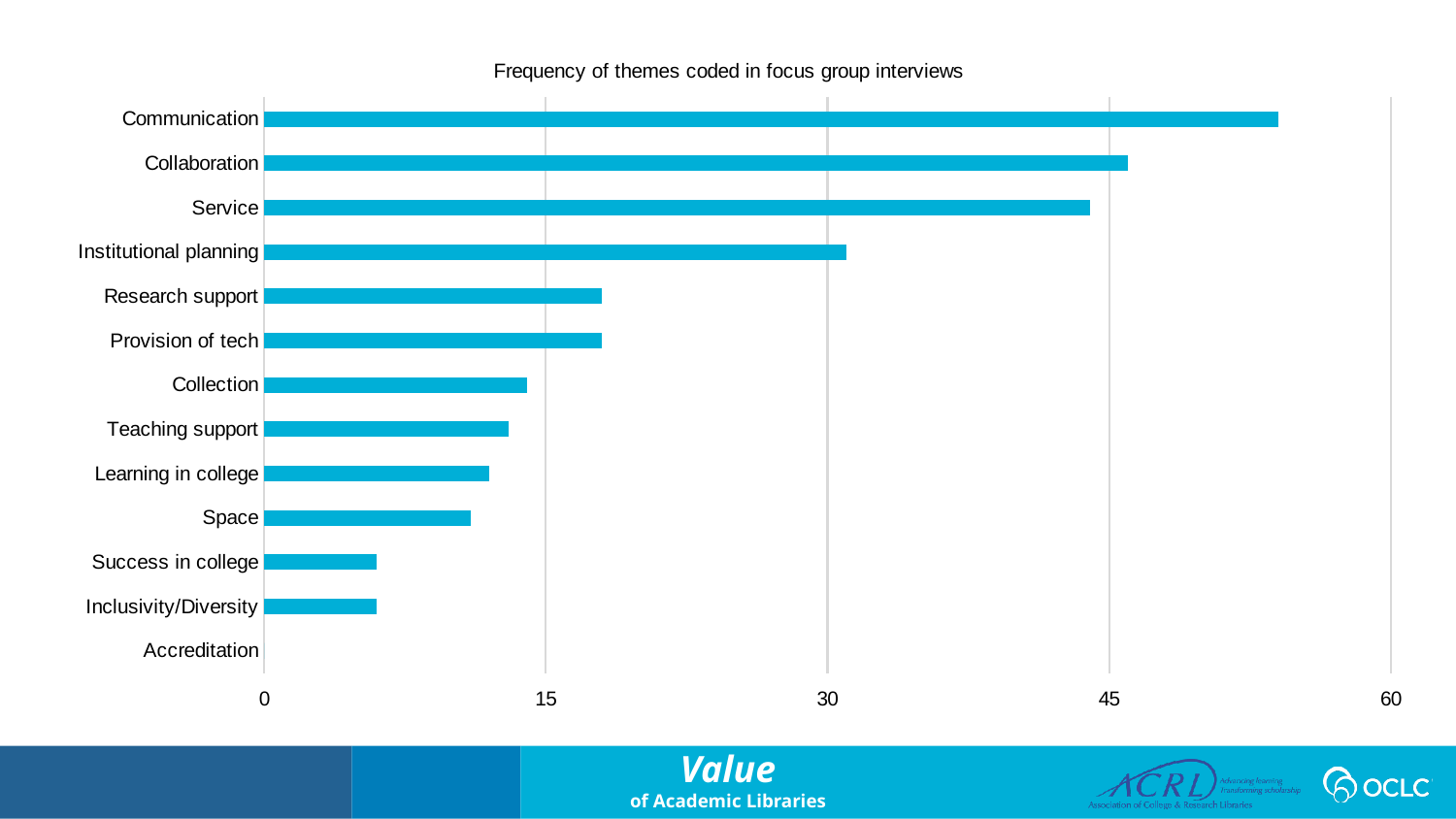
Is the value for Communication greater or less than 45? greater How many themes (categories) are listed on the chart? 13 Which has a higher frequency, Communication or Collaboration? Communication Which has a higher frequency, Service or Institutional planning? Service Which theme has the highest frequency? Communication What kind of chart is shown on the slide? bar chart What is the title of the chart? Frequency of themes coded in focus group interviews Is the value for Institutional planning greater or less than 30? greater Is the value for Research support greater or less than 15? greater Which theme has the lowest frequency? Accreditation